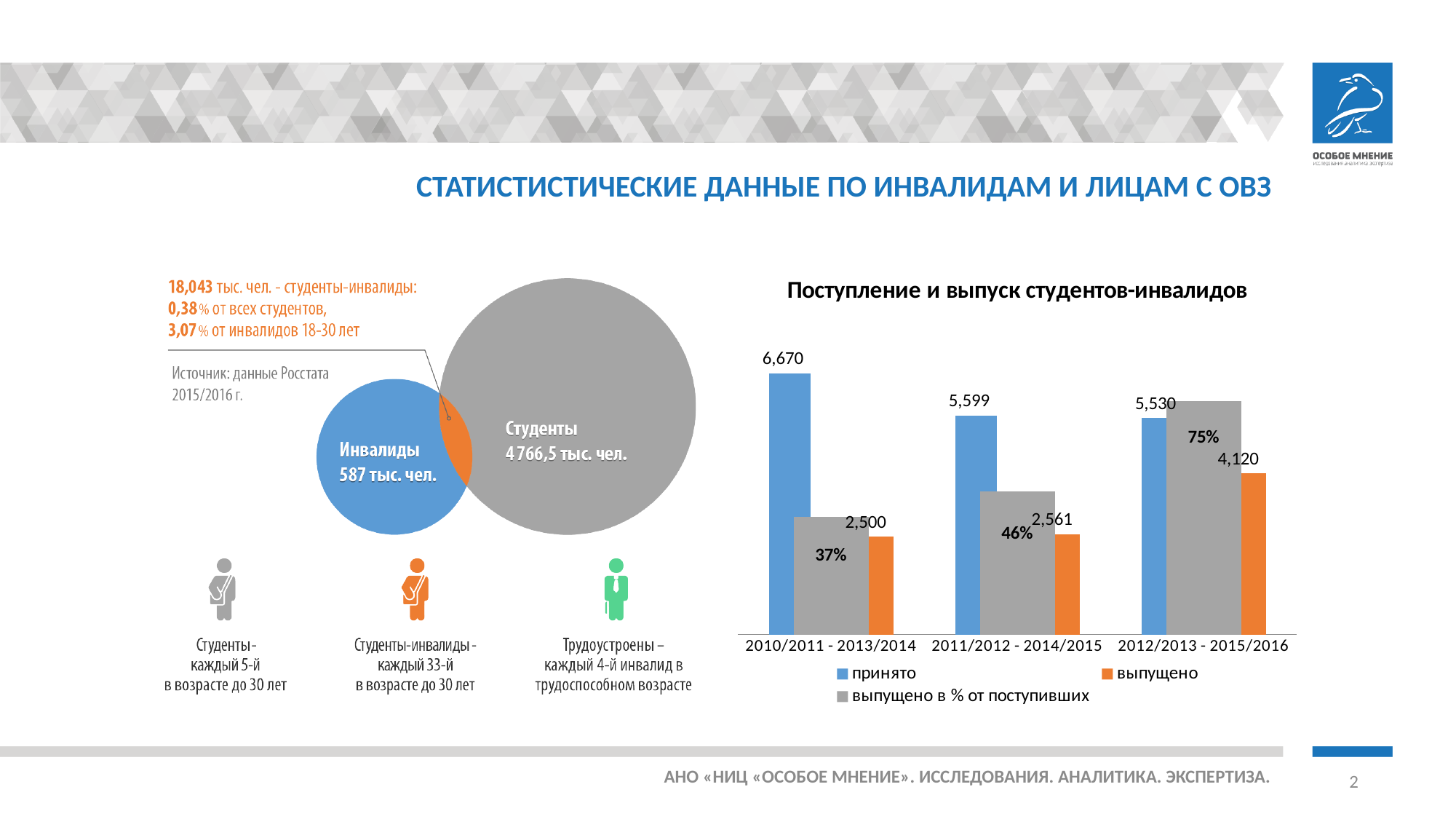
In the chart 'Поступление и выпуск студентов-инвалидов', which period has the lowest value for 'выпущено'? 2010/2011 - 2013/2014 In the chart 'Поступление и выпуск студентов-инвалидов', which period has the highest value for 'принято'? 2010/2011 - 2013/2014 In the chart 'Поступление и выпуск студентов-инвалидов', how many series does the legend list? 3 What kind of chart is 'Поступление и выпуск студентов-инвалидов'? bar chart In the chart 'Поступление и выпуск студентов-инвалидов', what is the value of 'принято' for 2010/2011 - 2013/2014? 6,670 In the chart 'Поступление и выпуск студентов-инвалидов', does the 'принято' value rise or fall across the periods from left to right? falls In the chart 'Поступление и выпуск студентов-инвалидов', what is the value of 'выпущено в % от поступивших' for 2011/2012 - 2014/2015? 46% In the chart 'Поступление и выпуск студентов-инвалидов', which period has the larger 'выпущено' value: 2011/2012 - 2014/2015 or 2012/2013 - 2015/2016? 2012/2013 - 2015/2016 In the chart 'Поступление и выпуск студентов-инвалидов', which colour represents the 'выпущено' series? orange In the chart 'Поступление и выпуск студентов-инвалидов', what is the difference between 'принято' and 'выпущено' for 2010/2011 - 2013/2014? 4,170 In the chart 'Поступление и выпуск студентов-инвалидов', what is the value of 'выпущено' for 2012/2013 - 2015/2016? 4,120 In the chart 'Поступление и выпуск студентов-инвалидов', how many periods are shown on the x axis? 3